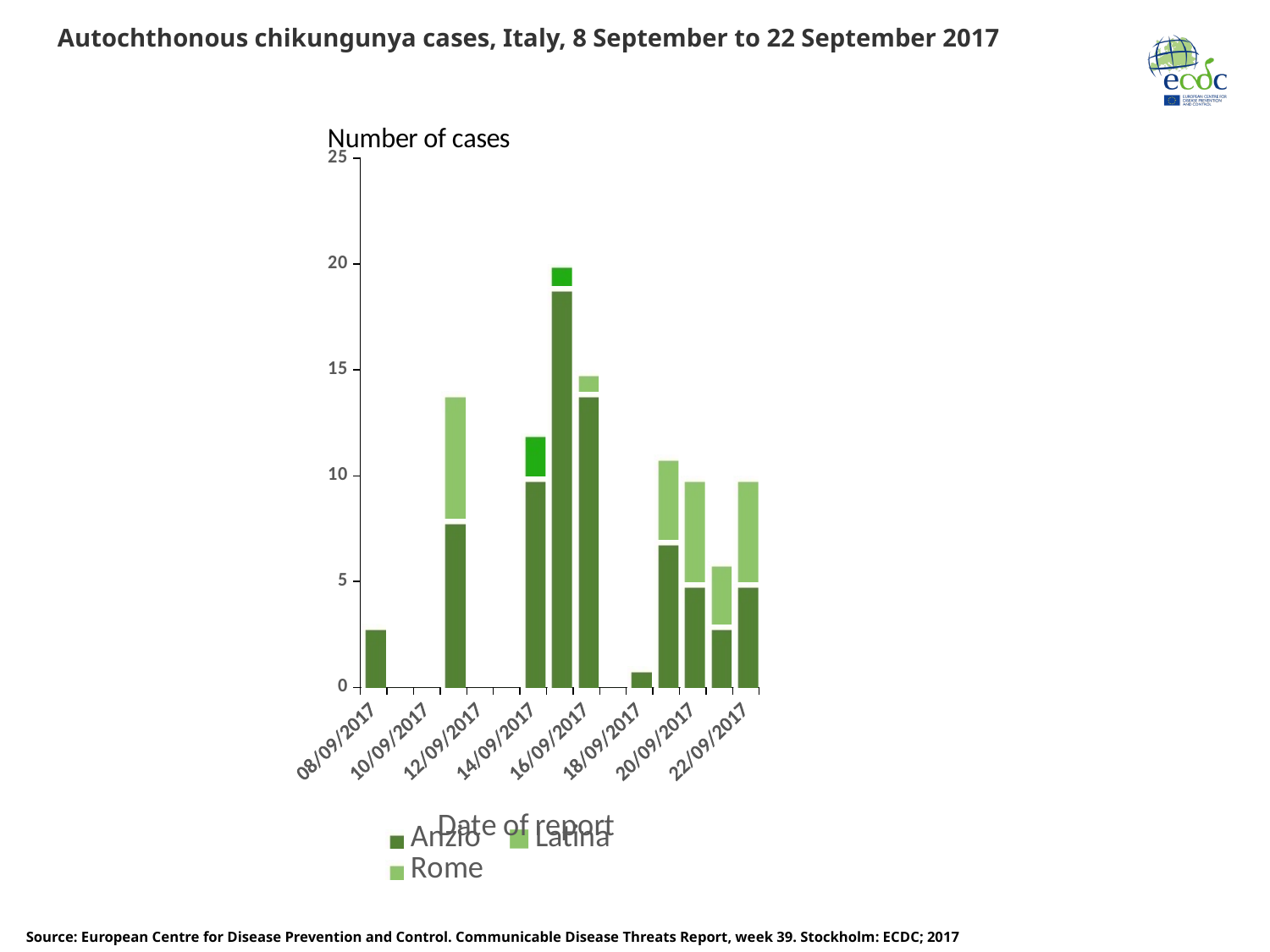
Is the total number of cases reported on 14/09/2017 greater or less than 10? greater What is the label of the vertical axis? Number of cases How many series does the legend list? 3 Is the total number of cases reported on 18/09/2017 greater or less than 5? less Which date has the larger total number of cases, 08/09/2017 or 14/09/2017? 14/09/2017 Is the total number of cases reported on 22/09/2017 greater or less than 5? greater Which locations are listed in the legend? Anzio, Latina, Rome Which date has the larger total number of cases, 18/09/2017 or 22/09/2017? 22/09/2017 What kind of chart is shown on the slide? Stacked bar chart How many date labels are shown along the x axis? 8